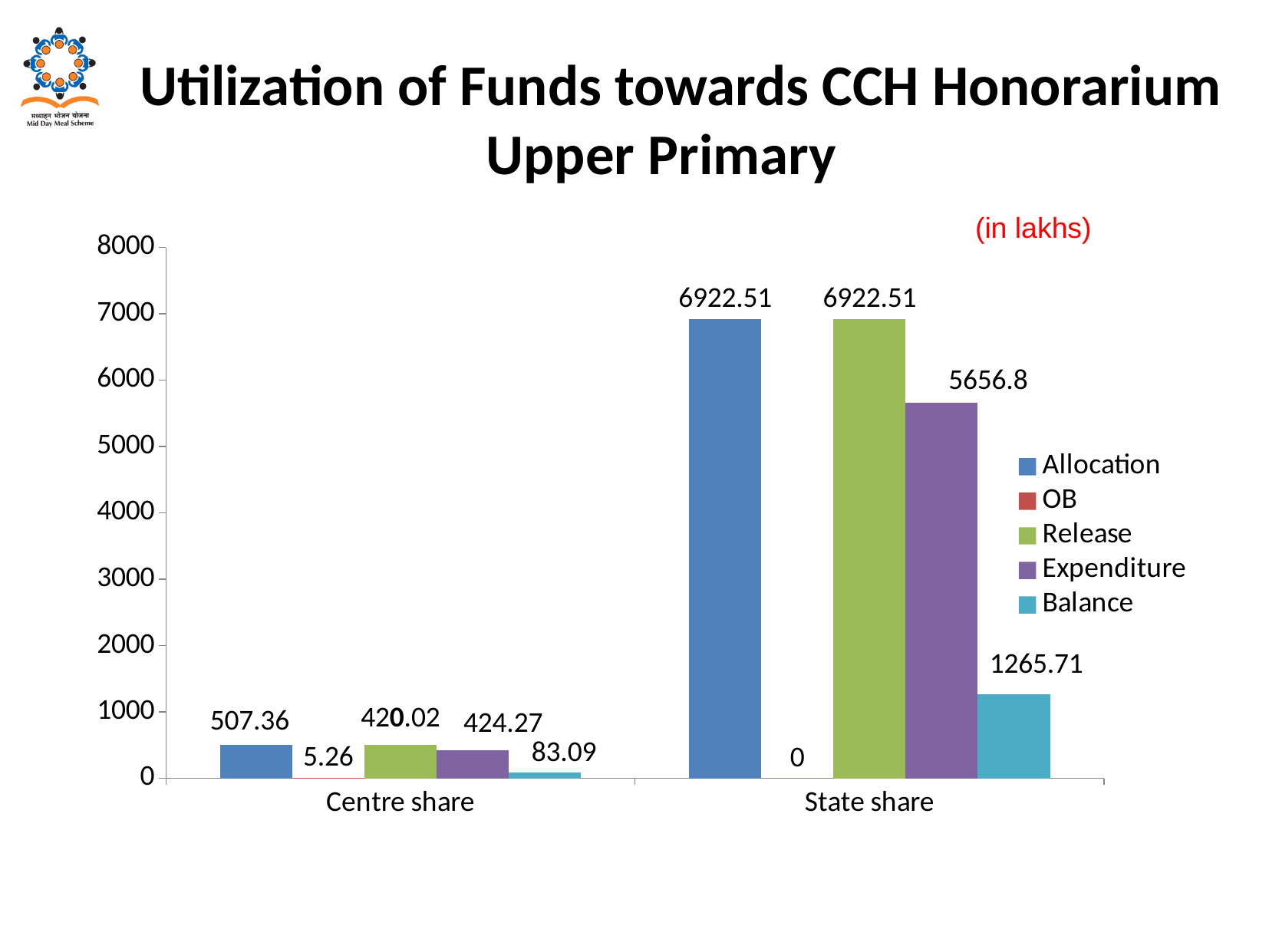
How many categories are shown on the x axis? 2 How many series does the legend list? 5 What is the Balance value for Centre share? 83.09 Which series has the highest value for Centre share? Allocation What kind of chart is shown on the slide? Bar chart Is the Balance value for State share greater or less than 1000? greater What is the difference between Release and Expenditure for State share? 1265.71 Which series has the lowest value for State share? OB What is the Expenditure value for State share? 5656.8 What is the OB value for Centre share? 5.26 What is the Allocation value for State share? 6922.51